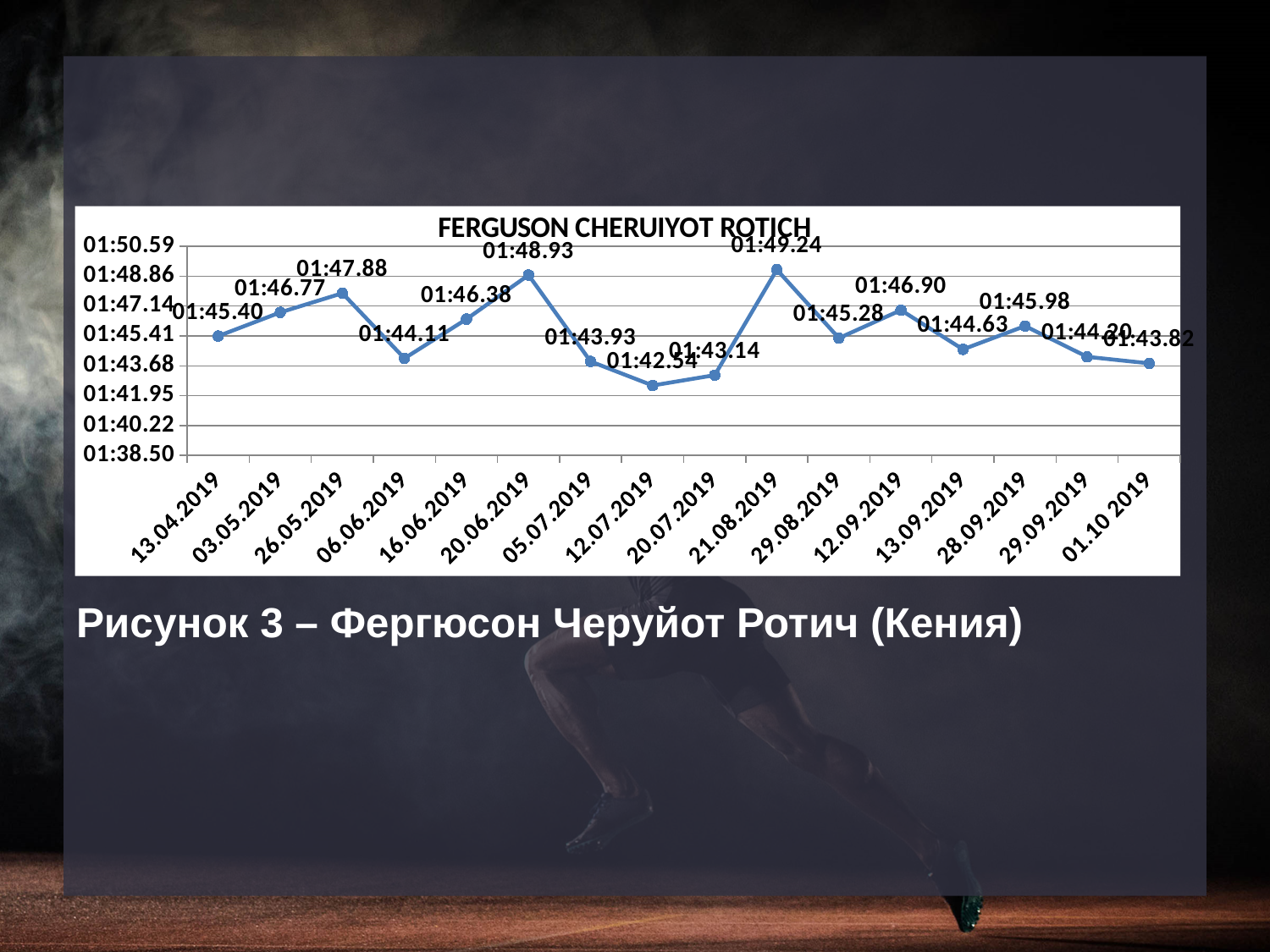
What is the title of the chart? FERGUSON CHERUIYOT ROTICH On which date is the highest value recorded? 21.08.2019 What type of chart is shown on the slide? line chart Do the values rise or fall from 21.08.2019 to 29.08.2019? fall What is the value for 20.06.2019? 01:48.93 Which is larger, the value for 26.05.2019 or the value for 06.06.2019? 26.05.2019 How many data points are plotted on the chart? 16 What is the value for 01.10 2019? 01:43.82 What is the value for 13.04.2019? 01:45.40 What is the value for 29.08.2019? 01:45.28 What is the value for 12.07.2019? 01:42.54 On which date is the lowest value recorded? 12.07.2019